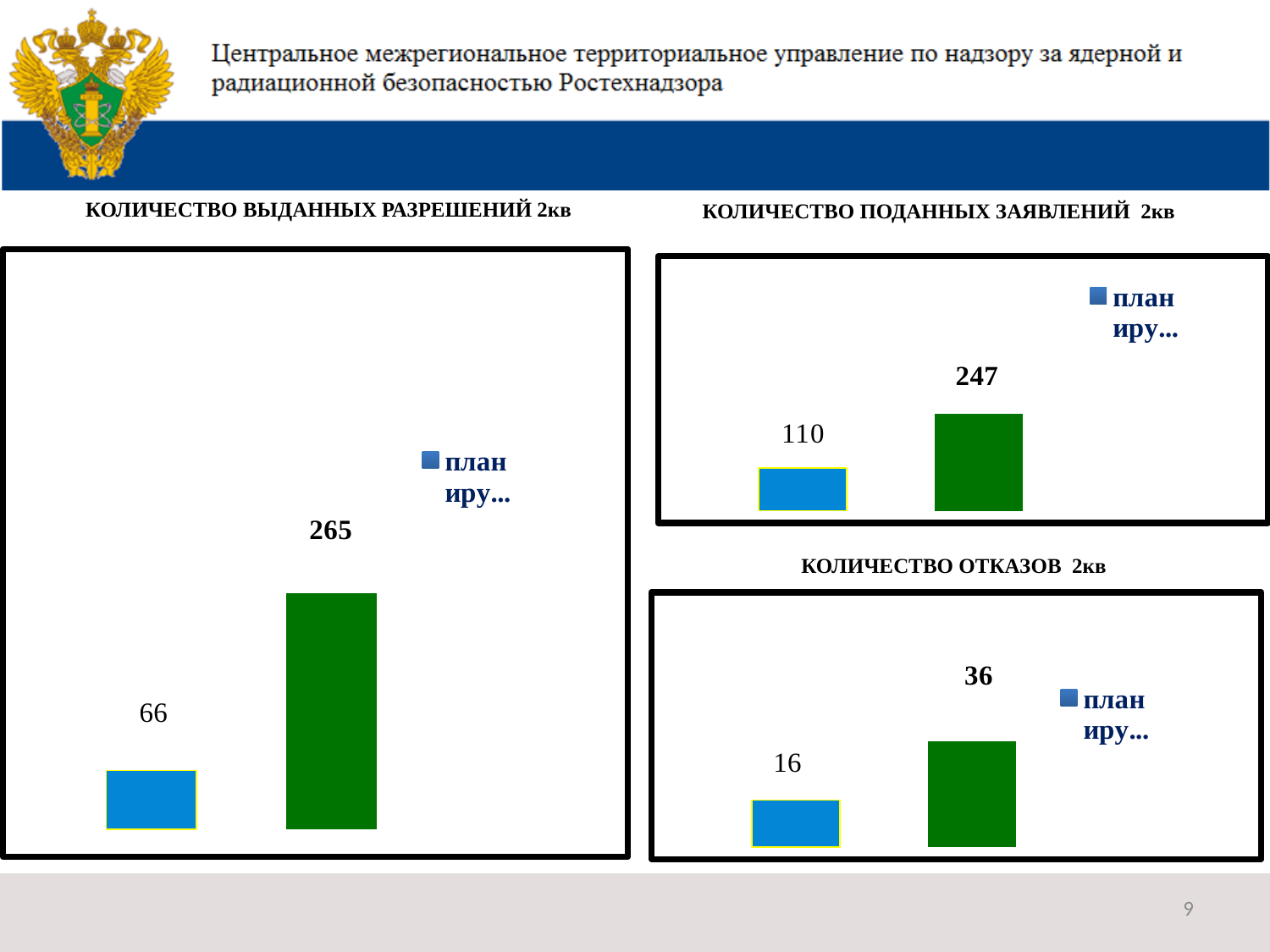
In the chart titled 'КОЛИЧЕСТВО ПОДАННЫХ ЗАЯВЛЕНИЙ 2кв', what value is shown on the blue bar? 110 In the chart titled 'КОЛИЧЕСТВО ПОДАННЫХ ЗАЯВЛЕНИЙ 2кв', what value is shown on the green bar? 247 What kind of chart is the one titled 'КОЛИЧЕСТВО ВЫДАННЫХ РАЗРЕШЕНИЙ 2кв'? bar chart How many charts are shown on the slide? 3 In the chart titled 'КОЛИЧЕСТВО ВЫДАННЫХ РАЗРЕШЕНИЙ 2кв', what value is shown on the blue bar? 66 In the chart titled 'КОЛИЧЕСТВО ПОДАННЫХ ЗАЯВЛЕНИЙ 2кв', which bar is taller, the blue one or the green one? the green one In the chart titled 'КОЛИЧЕСТВО ВЫДАННЫХ РАЗРЕШЕНИЙ 2кв', what is the difference between the green bar and the blue bar? 199 In the chart titled 'КОЛИЧЕСТВО ОТКАЗОВ 2кв', what value is shown on the green bar? 36 In the chart titled 'КОЛИЧЕСТВО ОТКАЗОВ 2кв', what is the difference between the green bar and the blue bar? 20 In the chart titled 'КОЛИЧЕСТВО ВЫДАННЫХ РАЗРЕШЕНИЙ 2кв', what value is shown on the green bar? 265 In the chart titled 'КОЛИЧЕСТВО ОТКАЗОВ 2кв', what value is shown on the blue bar? 16 How many bars are plotted in the chart titled 'КОЛИЧЕСТВО ОТКАЗОВ 2кв'? 2